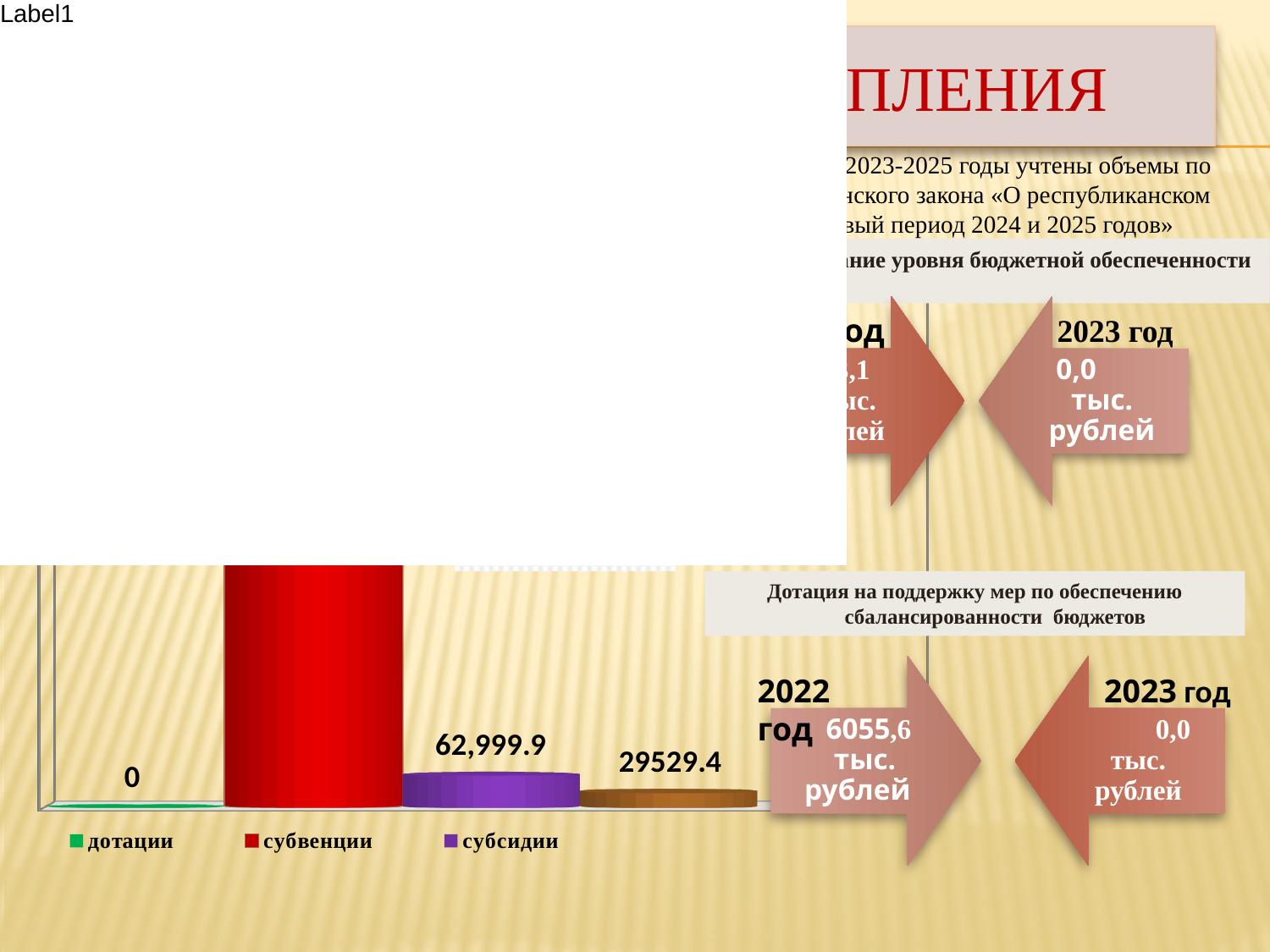
How many legend entries are visible below the chart? 3 What is the difference between the values for субсидии and дотации? 62,999.9 What kind of chart is shown on the slide? bar chart What colour is the bar for субвенции? red What value is shown for дотации in the bar chart? 0 Which category has the lowest value in the chart? дотации What value is shown for субсидии in the bar chart? 62,999.9 What colour is the bar for субсидии? purple How many bars are visible in the chart? 4 Which category has the highest bar in the chart? субвенции Which is larger in the chart, субвенции or субсидии? субвенции Which is larger in the chart, субсидии or дотации? субсидии